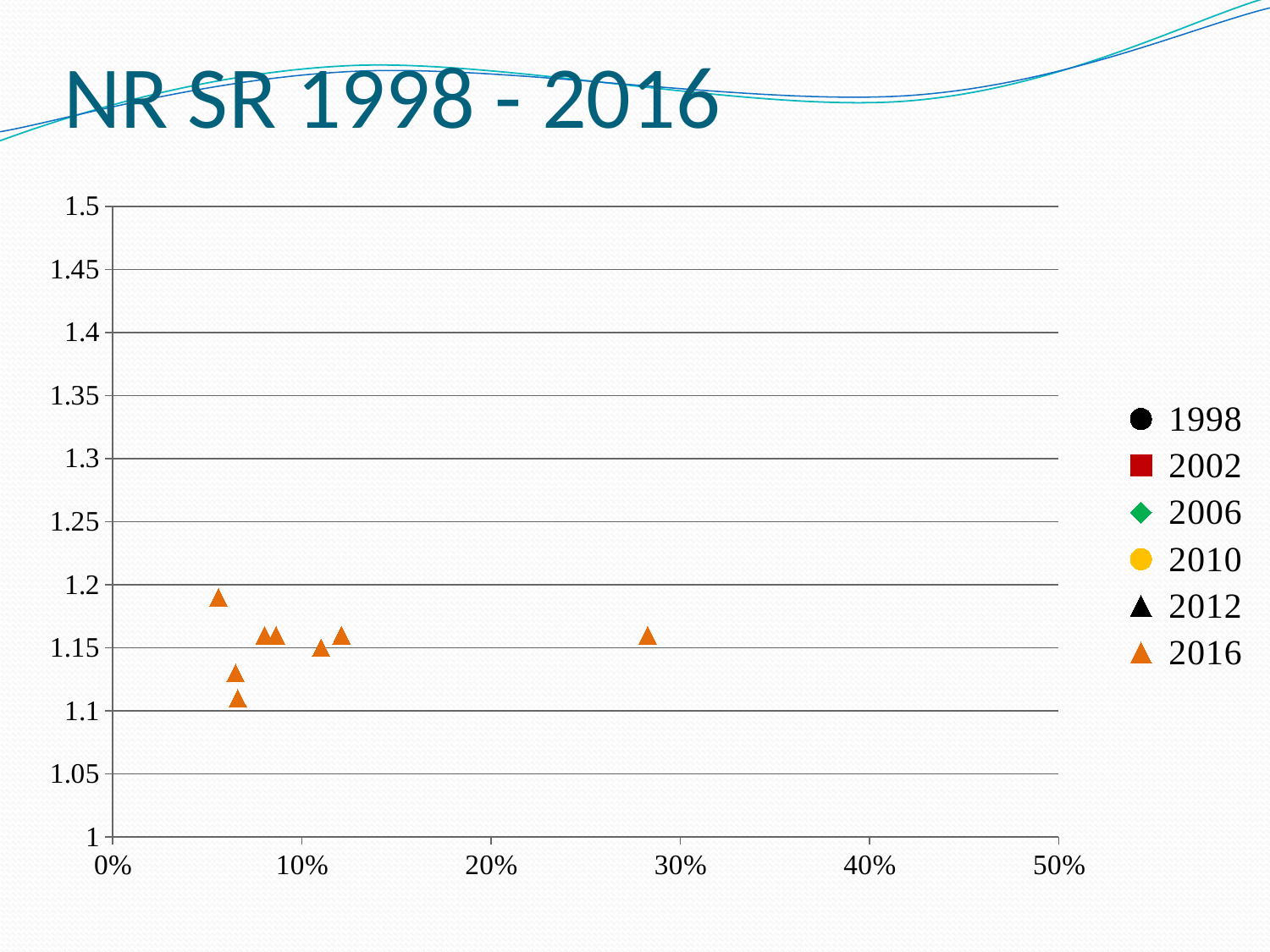
What kind of chart is shown on the slide? scatter chart What is the maximum value shown on the x axis? 50% Is the x value of the rightmost 2016 point greater or less than 20%? greater Is the y value of the highest 2016 point greater or less than 1.3? less Which series is the only one with points visible on the chart? 2016 How many 2016 points are plotted on the chart? 8 Is the leftmost 2016 point higher or lower on the y axis than the rightmost 2016 point? higher What is the title of the chart? NR SR 1998 - 2016 How many series does the legend list? 6 Is the y value of the lowest 2016 point greater or less than 1.05? greater Which series is plotted with orange triangles? 2016